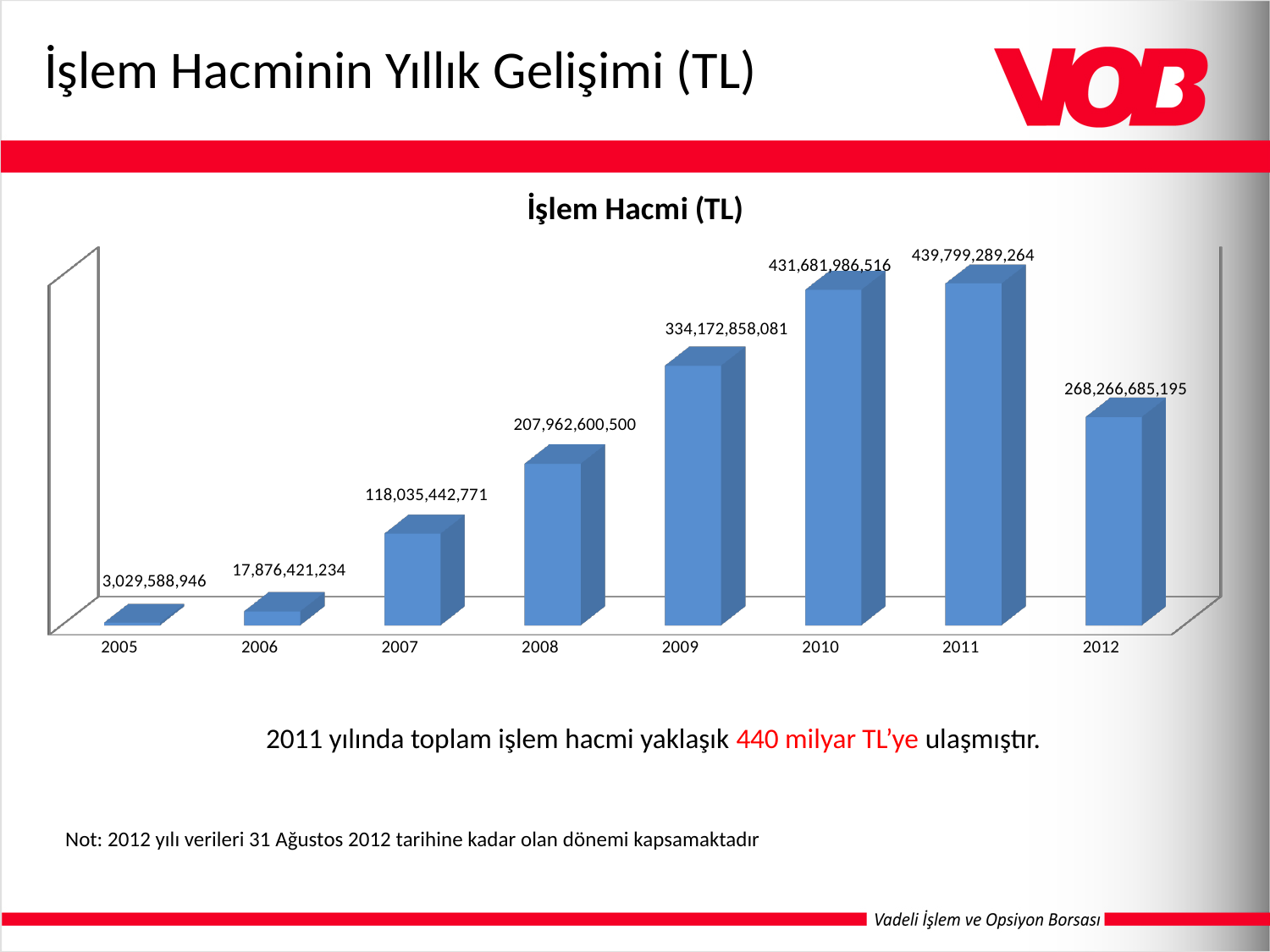
What is the value for 2012 in the İşlem Hacmi (TL) chart? 268,266,685,195 What is the difference between the values for 2006 and 2005 in the İşlem Hacmi (TL) chart? 14,846,832,288 Which year has the lowest value in the İşlem Hacmi (TL) chart? 2005 What kind of chart is the İşlem Hacmi (TL) chart? Bar chart How do the values in the İşlem Hacmi (TL) chart change from 2005 to 2011? They rise every year What is the value for 2005 in the İşlem Hacmi (TL) chart? 3,029,588,946 Which is larger in the İşlem Hacmi (TL) chart, the value for 2009 or the value for 2012? 2009 How many years are shown in the İşlem Hacmi (TL) chart? 8 Which year has the highest value in the İşlem Hacmi (TL) chart? 2011 What is the value for 2007 in the İşlem Hacmi (TL) chart? 118,035,442,771 What is the value for 2009 in the İşlem Hacmi (TL) chart? 334,172,858,081 What is the difference between the values for 2011 and 2010 in the İşlem Hacmi (TL) chart? 8,117,302,748